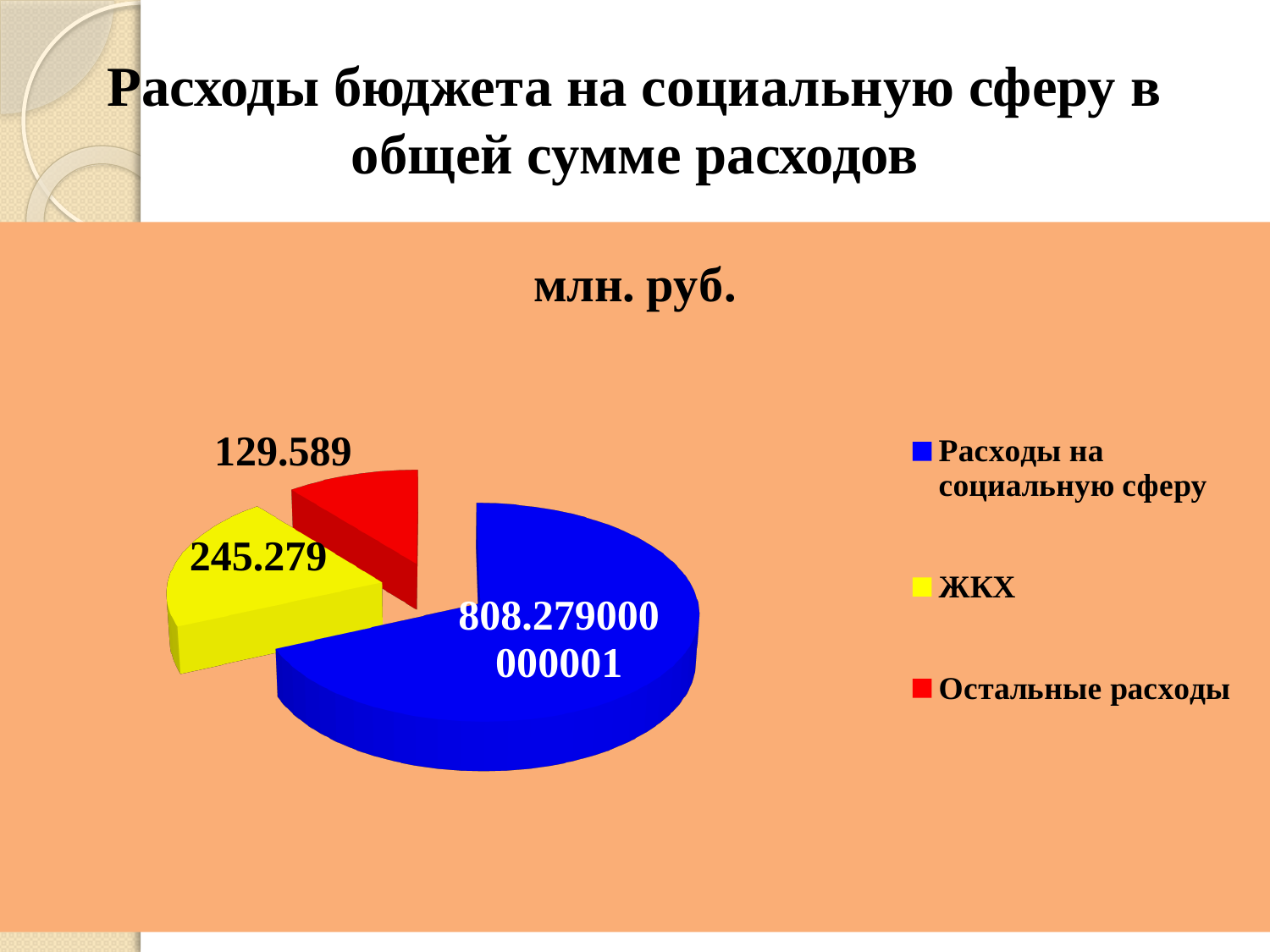
What colour is the slice for ЖКХ? yellow What is the title of the chart? млн. руб. What type of chart is shown on the slide? pie chart How many entries does the legend list? 3 Which category has the smallest slice of the pie? Остальные расходы What is the value for ЖКХ? 245.279 What is the value shown for Расходы на социальную сферу? 808.279000000001 What is the difference between the values for ЖКХ and Остальные расходы? 115.69 Which category has the largest slice of the pie? Расходы на социальную сферу What is the value for Остальные расходы? 129.589 How many slices does the pie chart have? 3 Which is larger, ЖКХ or Остальные расходы? ЖКХ